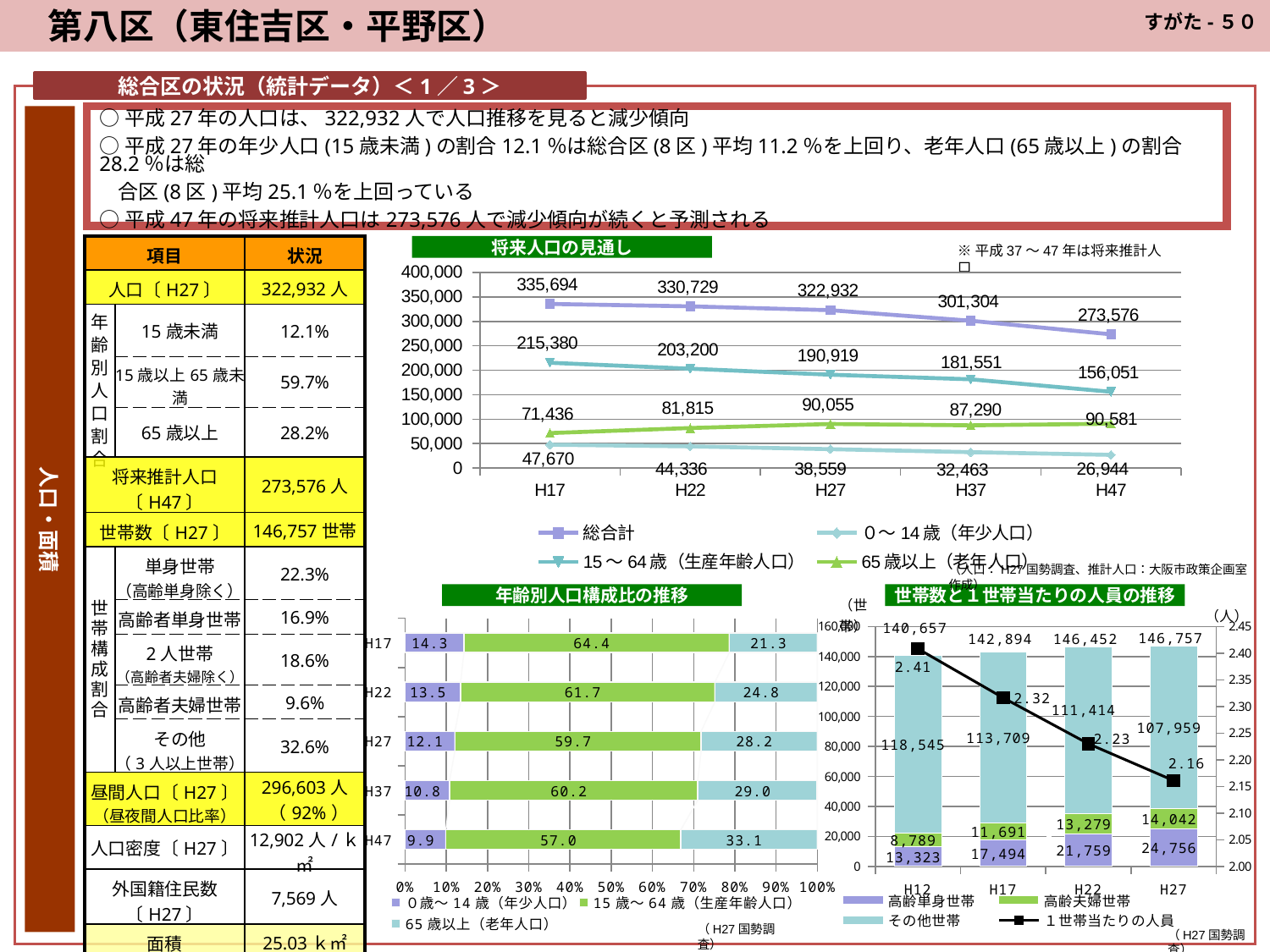
In the 将来人口の見通し chart, what is the value of 0～14歳（年少人口） for H47? 26,944 In the 年齢別人口構成比の推移 chart, which year has the highest share of 0歳～14歳（年少人口）? H17 In the 年齢別人口構成比の推移 chart, what is the share of 65歳以上（老年人口） for H47? 33.1 In the 世帯数と1世帯当たりの人員の推移 chart, which year has the lowest その他世帯 value? H27 In the 世帯数と1世帯当たりの人員の推移 chart, what is the value of 高齢夫婦世帯 for H27? 14,042 In the 将来人口の見通し chart, what is the difference between the 15～64歳（生産年齢人口） values for H17 and H47? 59,329 In the 年齢別人口構成比の推移 chart, what kind of chart is it? stacked bar chart In the 将来人口の見通し chart, does the 総合計 series rise or fall from H17 to H47? fall In the 世帯数と1世帯当たりの人員の推移 chart, how many years are shown on the x axis? 4 In the 将来人口の見通し chart, how many series does the legend list? 4 In the 将来人口の見通し chart, what is the 総合計 value for H27? 322,932 In the 世帯数と1世帯当たりの人員の推移 chart, what is the 1世帯当たりの人員 value for H12? 2.41